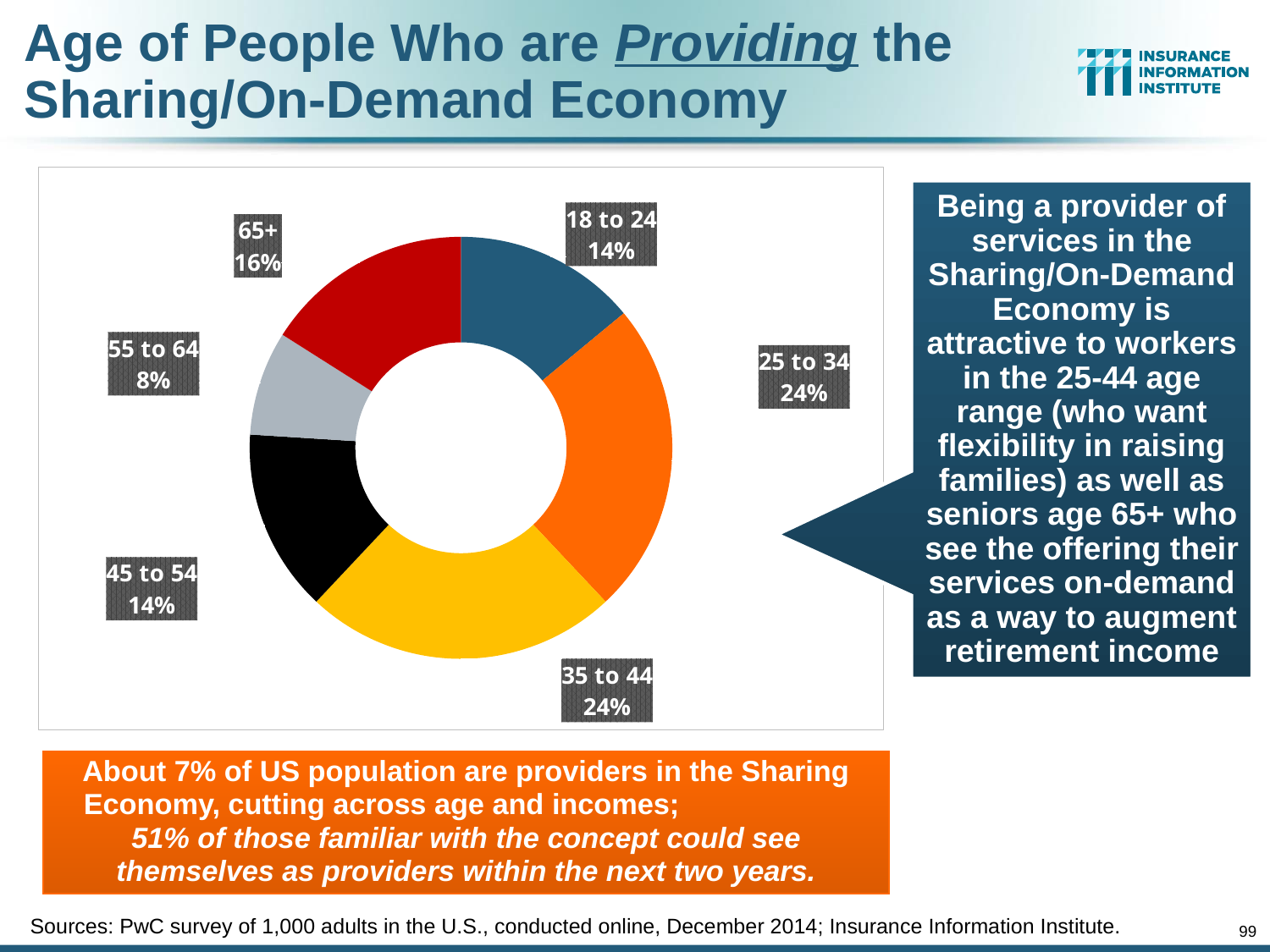
Which has a larger share of providers, the 25 to 34 group or the 55 to 64 group? 25 to 34 What is the difference in percentage points between the 65+ group and the 55 to 64 group? 8 What kind of chart is used to show the age of providers? Pie (doughnut) chart Which has a larger share of providers, the 65+ group or the 18 to 24 group? 65+ What share of providers in the Sharing/On-Demand Economy are aged 18 to 24? 14% How many age groups are shown in the chart? 6 What percentage of providers are in the 25 to 34 age group? 24% What is the combined share of providers aged 25 to 44? 48% What is the difference in percentage points between the 35 to 44 group and the 45 to 54 group? 10 What percentage of providers are aged 55 to 64? 8% Which age group has the smallest share of providers? 55 to 64 What share of providers are aged 65+? 16%